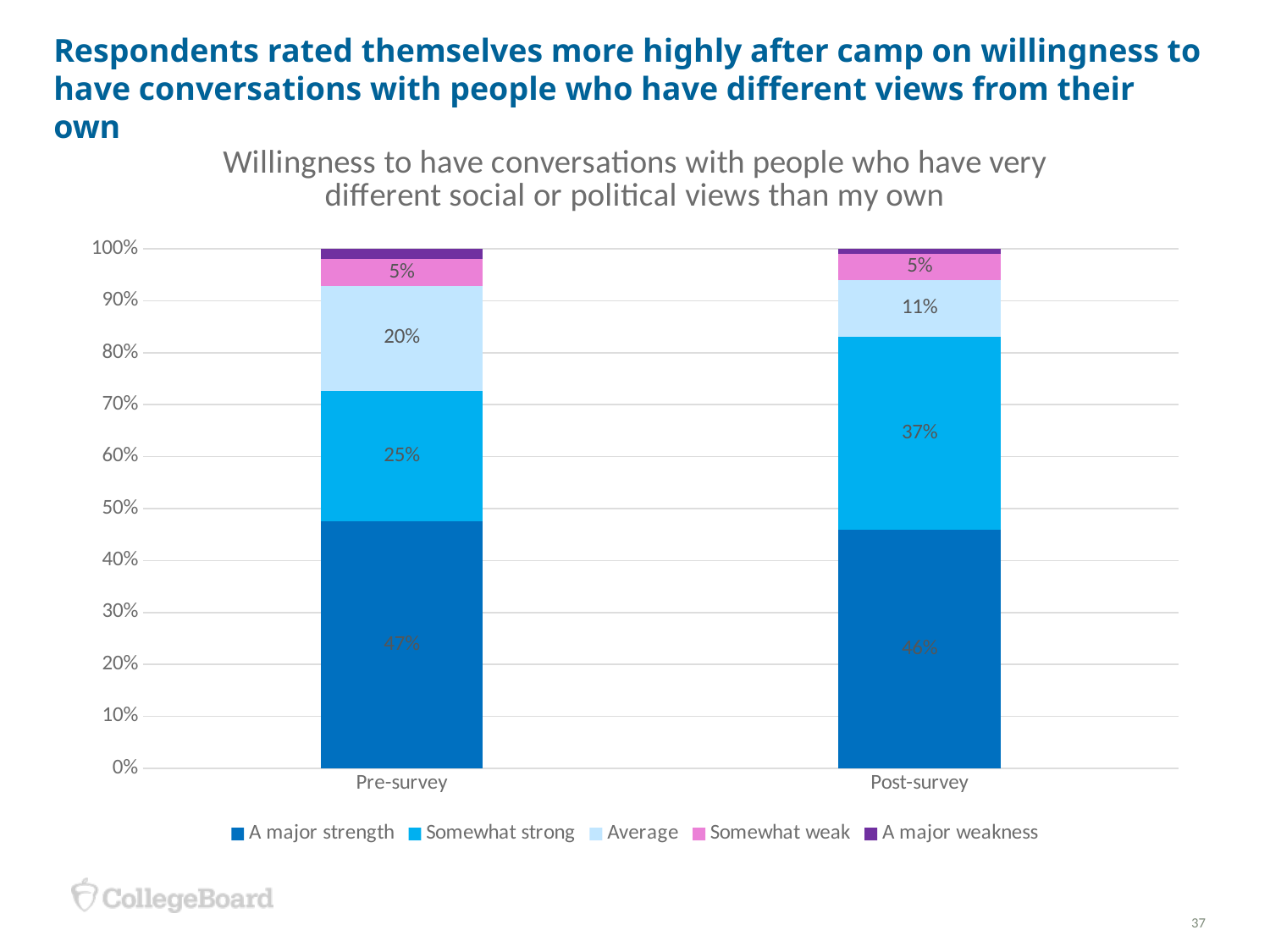
How many categories are shown on the x axis of the chart? 2 What type of chart is shown on the slide? Stacked bar chart What is the title of the chart? Willingness to have conversations with people who have very different social or political views than my own What is the 'Average' value for the Pre-survey bar? 20% Which is larger, the 'Somewhat strong' value for Pre-survey or for Post-survey? Post-survey What percentage of Pre-survey respondents rated this as 'A major strength'? 47% What is the 'Somewhat weak' value for the Post-survey bar? 5% How many series does the legend list? 5 By how many percentage points does the 'Somewhat strong' value for Post-survey exceed that for Pre-survey? 12 percentage points What percentage of Post-survey respondents rated this as 'Somewhat strong'? 37% What is the 'Average' value for the Post-survey bar? 11% Which rating segment is the largest in the Pre-survey bar? A major strength